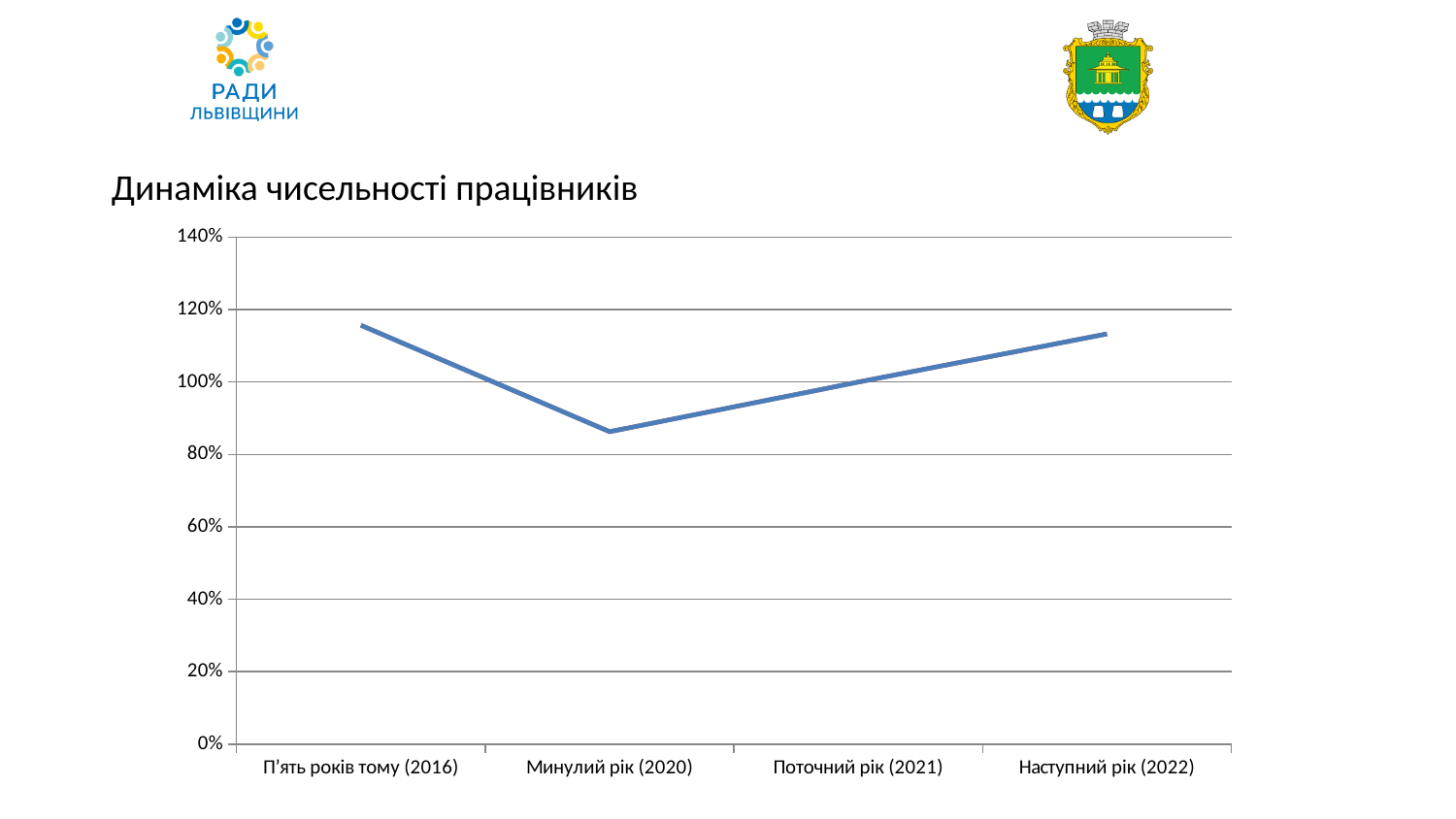
Is the value for Минулий рік (2020) greater or less than 100%? less What is the title of the chart? Динаміка чисельності працівників Is the value for Наступний рік (2022) greater or less than 100%? greater Is the value for П'ять років тому (2016) greater or less than 100%? greater Which is larger, the value for П'ять років тому (2016) or for Минулий рік (2020)? П'ять років тому (2016) Does the line rise or fall from Минулий рік (2020) to Наступний рік (2022)? rise What kind of chart is shown on the slide? line chart How many points are plotted on the line? 4 Which category has the lowest value? Минулий рік (2020) Which is larger, the value for Поточний рік (2021) or for Минулий рік (2020)? Поточний рік (2021)